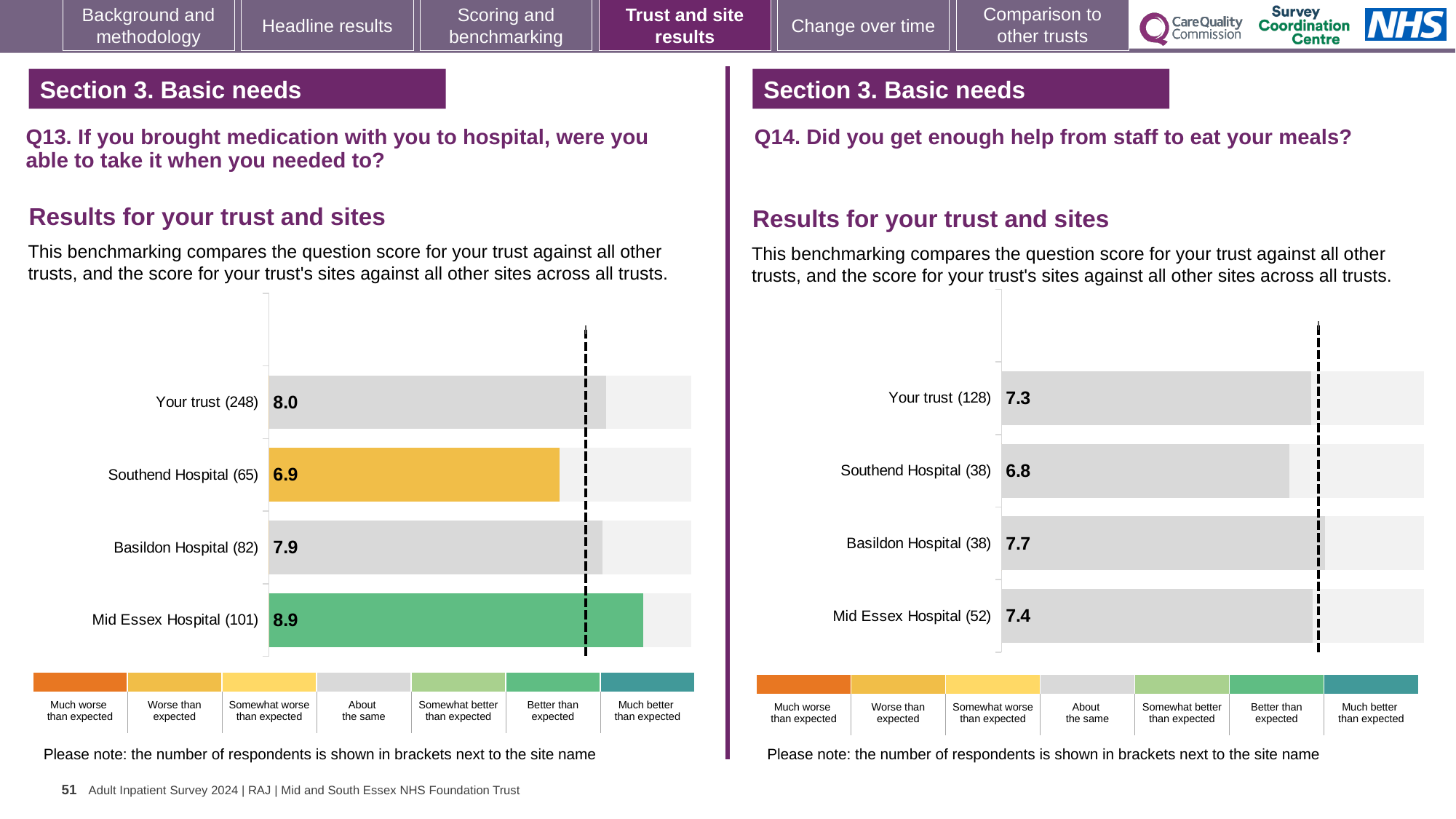
What type of chart is used on the Q13 chart (left)? Bar chart On the Q13 chart (left), how many respondents are shown for Your trust? 248 On the Q13 chart (left), which site has the lowest score? Southend Hospital On the Q14 chart (right), which site has the highest score? Basildon Hospital On the Q13 chart (left), what is the difference between the Mid Essex Hospital score and the Southend Hospital score? 2.0 On the Q13 chart (left), what is the score for Southend Hospital? 6.9 On the Q14 chart (right), what is the difference between the Basildon Hospital score and the Southend Hospital score? 0.9 On the Q13 chart (left), what is the score for Mid Essex Hospital? 8.9 On the Q14 chart (right), what is the score for Your trust? 7.3 How many bars are plotted on the Q14 chart (right)? 4 On the Q14 chart (right), which is larger, the score for Basildon Hospital or the score for Southend Hospital? Basildon Hospital On the Q13 chart (left), which benchmark category does the colour of the Mid Essex Hospital bar correspond to? Better than expected